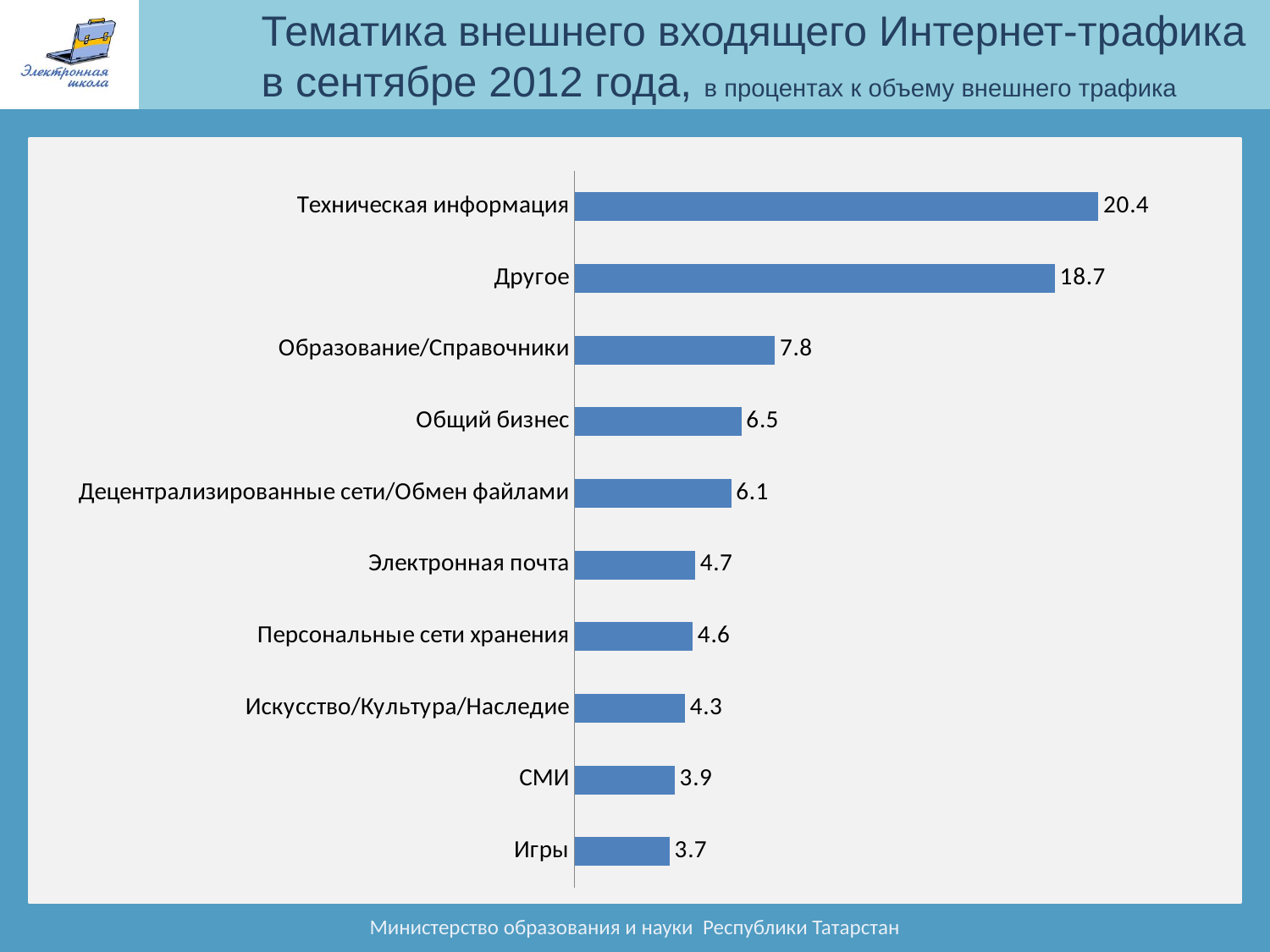
Which category has the lowest value? Игры What is the difference between the values for Техническая информация and Другое? 1.7 What is the value for Техническая информация? 20.4 What is the value for Игры? 3.7 What is the value for Электронная почта? 4.7 What is the value for Персональные сети хранения? 4.6 Which category has the highest value? Техническая информация What is the difference between the values for Общий бизнес and СМИ? 2.6 What is the value for Образование/Справочники? 7.8 What kind of chart is shown on the slide? Bar chart How many categories are shown in the chart? 10 Which is larger, the value for Децентрализированные сети/Обмен файлами or the value for Искусство/Культура/Наследие? Децентрализированные сети/Обмен файлами